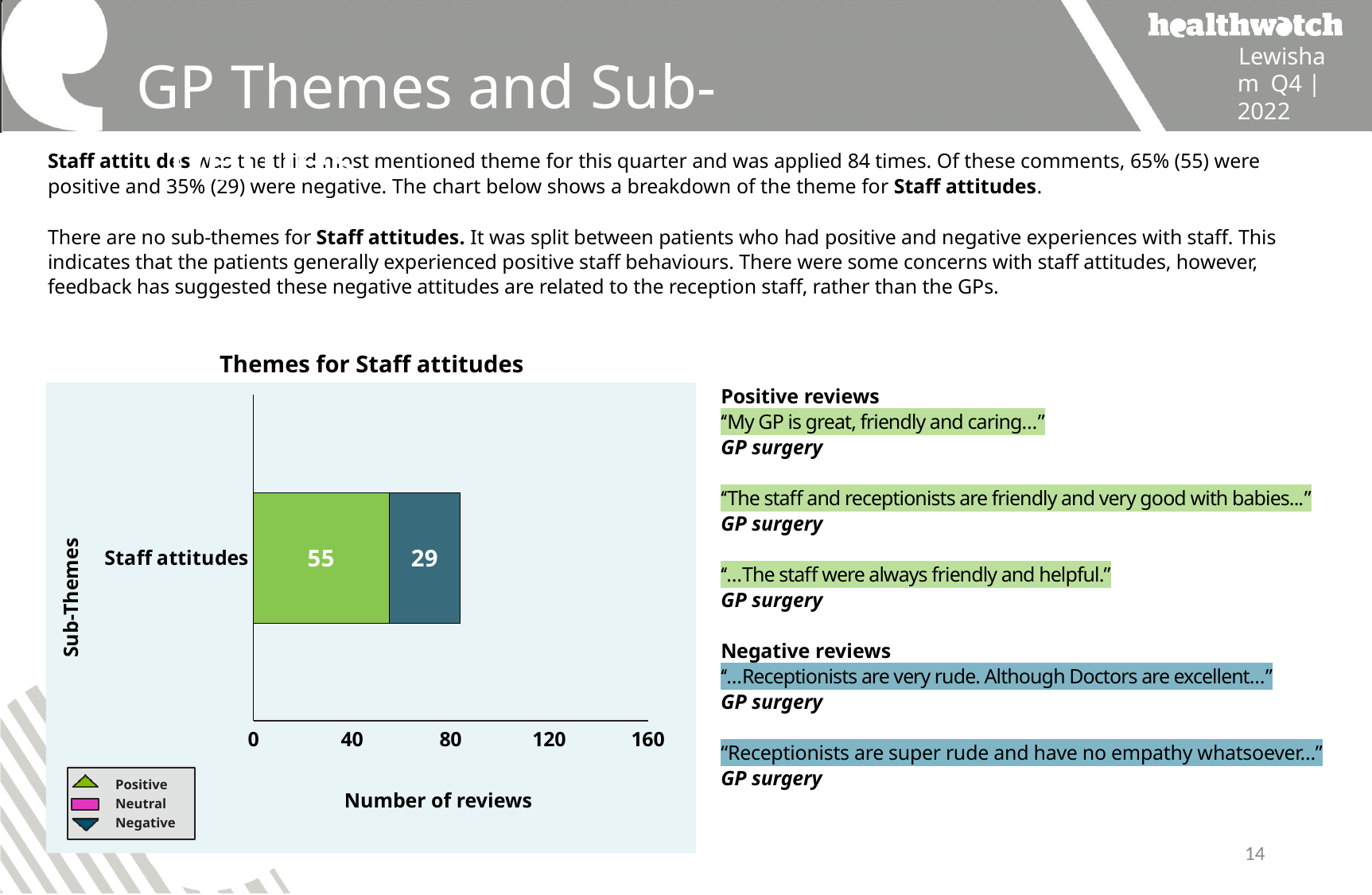
What kind of chart is shown? Stacked bar chart What is the number of Negative reviews for Staff attitudes? 29 What is the label of the x axis? Number of reviews Is the total length of the Staff attitudes bar greater or less than 120? less What is the total number of reviews in the Staff attitudes bar? 84 What is the title of the chart? Themes for Staff attitudes Which series has the larger value for Staff attitudes, Positive or Negative? Positive What is the number of Positive reviews for Staff attitudes? 55 What is the highest value shown on the x axis? 160 What is the difference between the Positive and Negative review counts for Staff attitudes? 26 How many sub-theme categories are plotted on the chart? 1 How many series does the legend list? 3